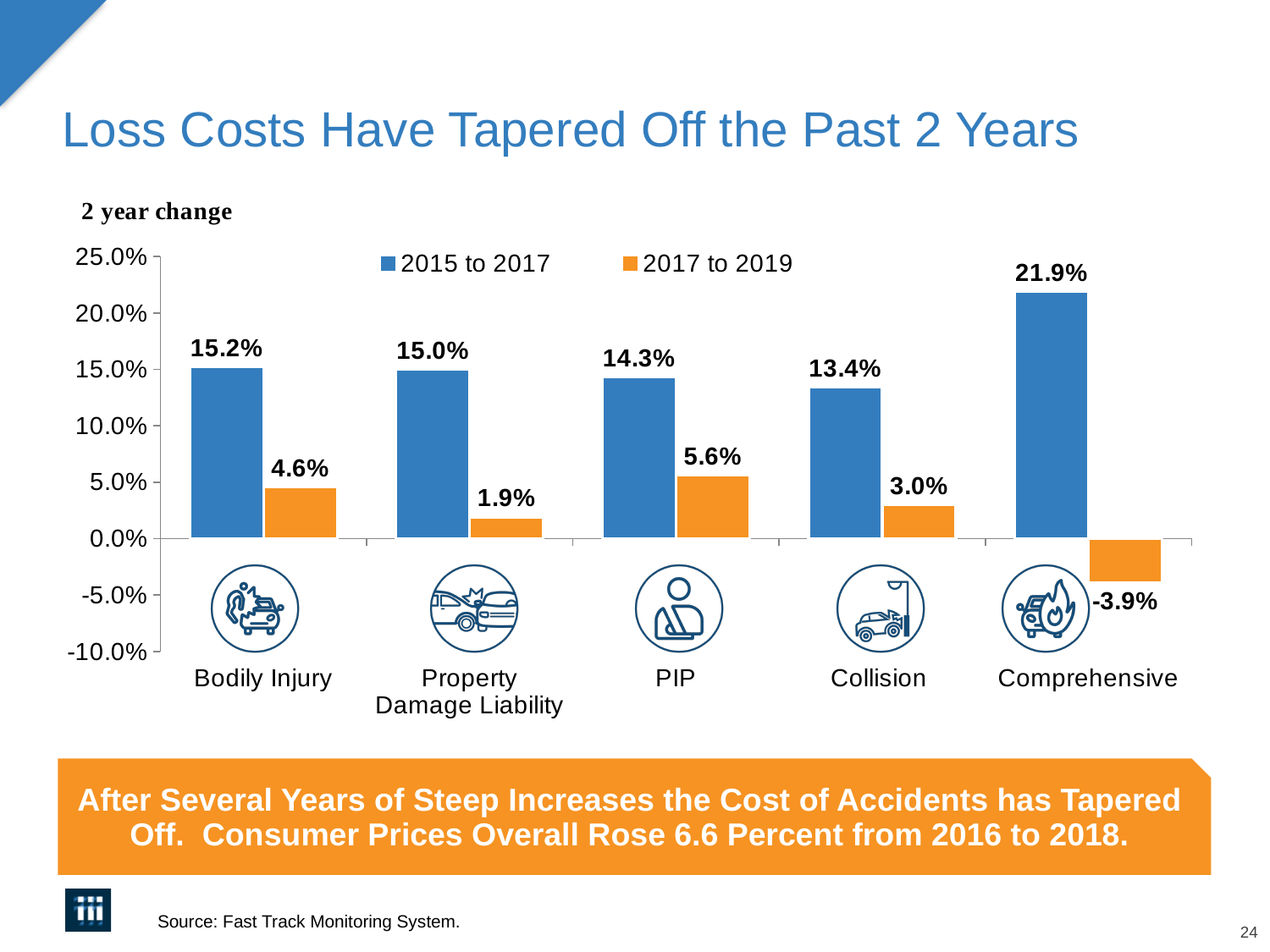
What is the 2015 to 2017 change for Comprehensive? 21.9% How many categories are shown on the x axis? 5 What kind of chart is shown on the slide? Bar chart Which category has the highest 2015 to 2017 change? Comprehensive What is the difference between the 2015 to 2017 and 2017 to 2019 changes for Bodily Injury? 10.6% What is the 2017 to 2019 change for PIP? 5.6% How many series does the legend list? 2 What is the 2017 to 2019 change for Property Damage Liability? 1.9% Which category has the lowest 2017 to 2019 change? Comprehensive What is the title of the chart? 2 year change Which is larger: the 2017 to 2019 change for PIP or for Collision? PIP Is the 2015 to 2017 change for Collision greater or less than 10.0%? greater